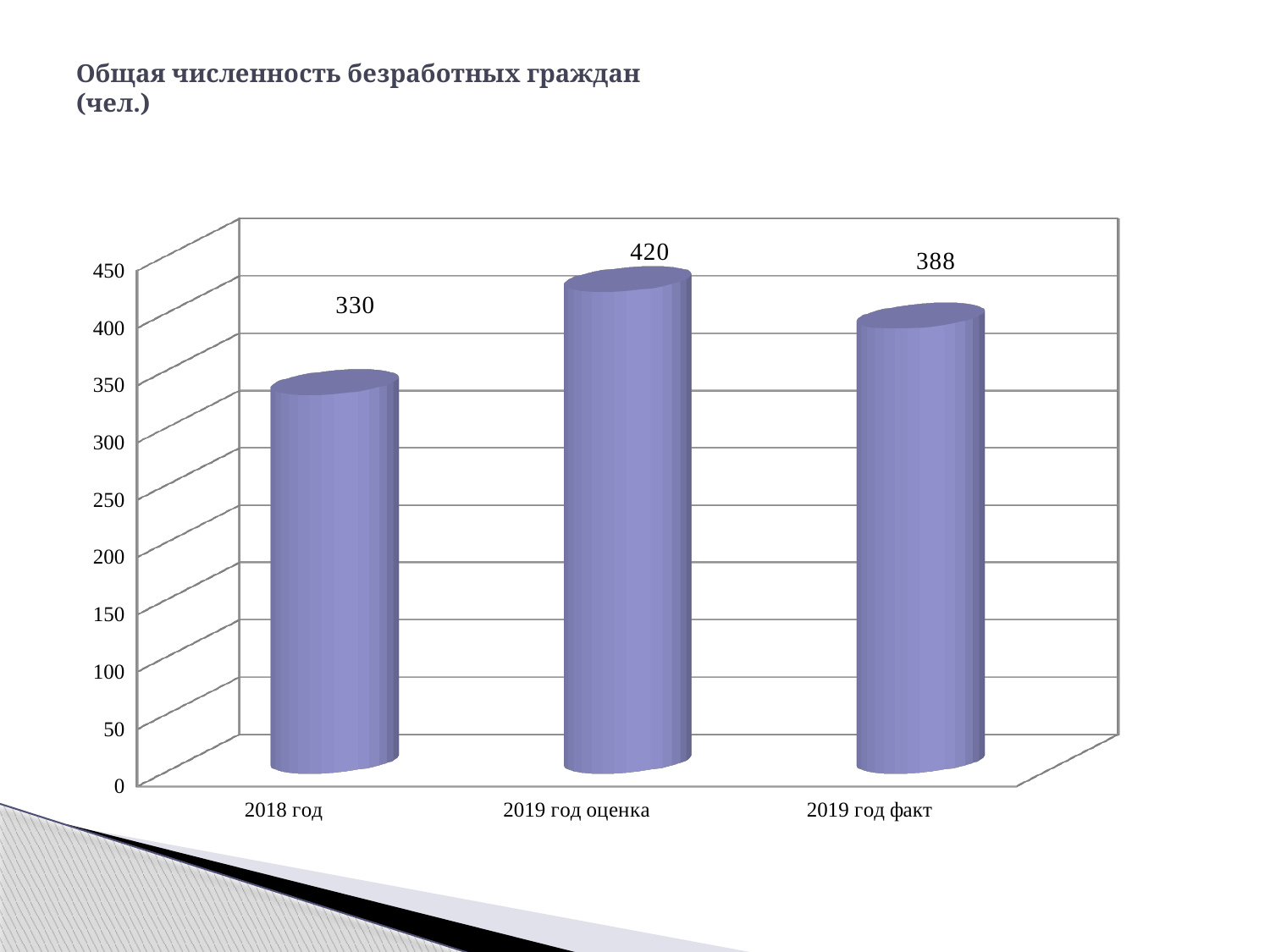
What is the value for 2018 год? 330 Which is larger, the value for 2018 год or the value for 2019 год факт? 2019 год факт Is the value for 2019 год факт greater or less than 350? greater What is the value for 2019 год факт? 388 What is the difference between the values for 2019 год оценка and 2019 год факт? 32 What kind of chart is shown on the slide? bar chart How many categories are shown on the x axis? 3 What is the value for 2019 год оценка? 420 What is the title of the chart? Общая численность безработных граждан (чел.) Which category has the highest value? 2019 год оценка What is the difference between the values for 2019 год факт and 2018 год? 58 Which category has the lowest value? 2018 год